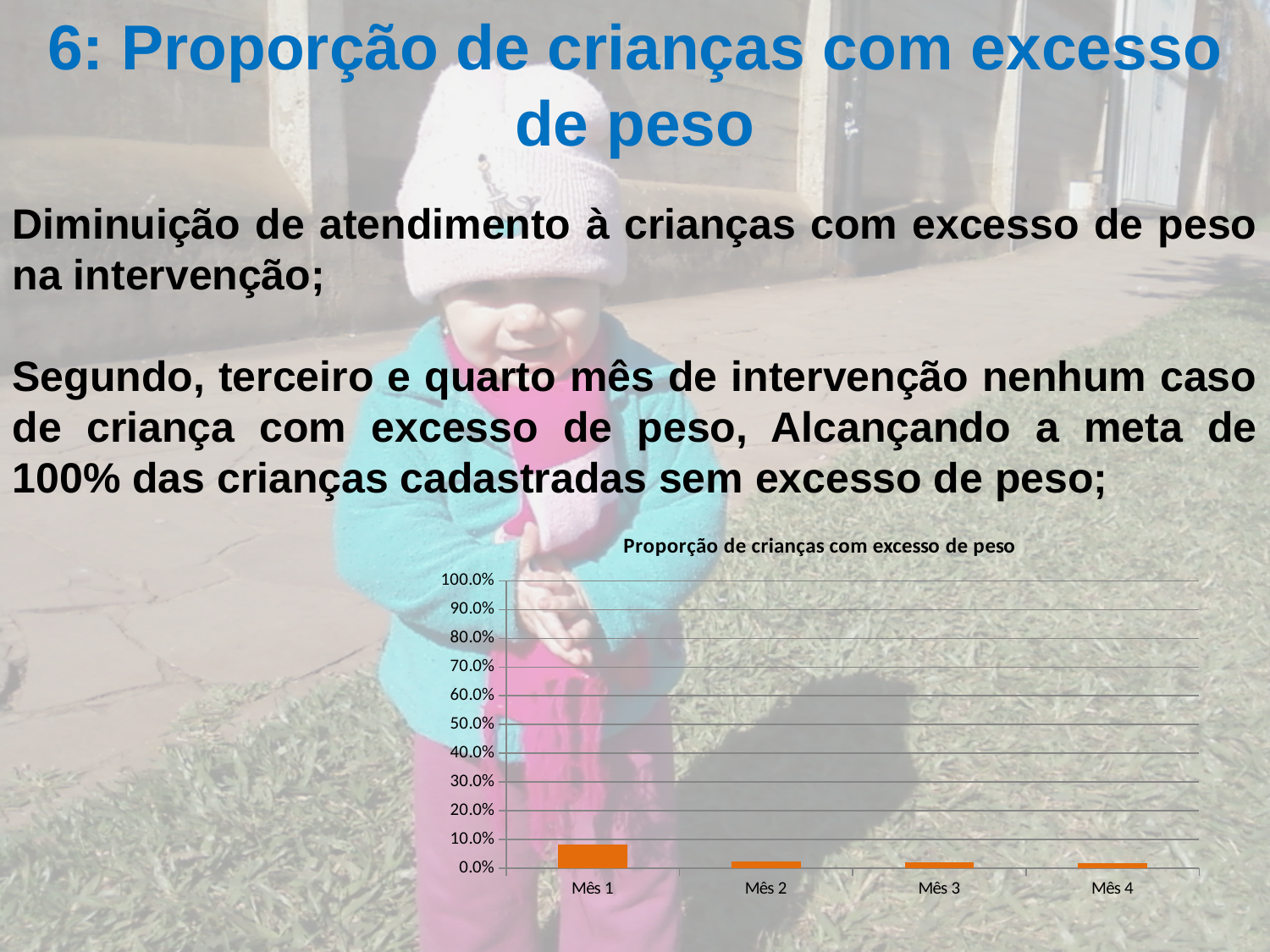
Is the value for Mês 3 greater or less than 10.0%? less What is the highest value labelled on the y axis of the chart? 100.0% Is the value for Mês 1 greater or less than 10.0%? less Which is larger, the value for Mês 1 or the value for Mês 2? Mês 1 How many months (categories) are shown on the x axis of the chart? 4 What is the title of the chart? Proporção de crianças com excesso de peso Do the values rise or fall from Mês 1 to Mês 4? fall Is the value for Mês 1 greater or less than 50.0%? less Which month has the highest proportion of children with excess weight? Mês 1 What kind of chart is shown on the slide? bar chart